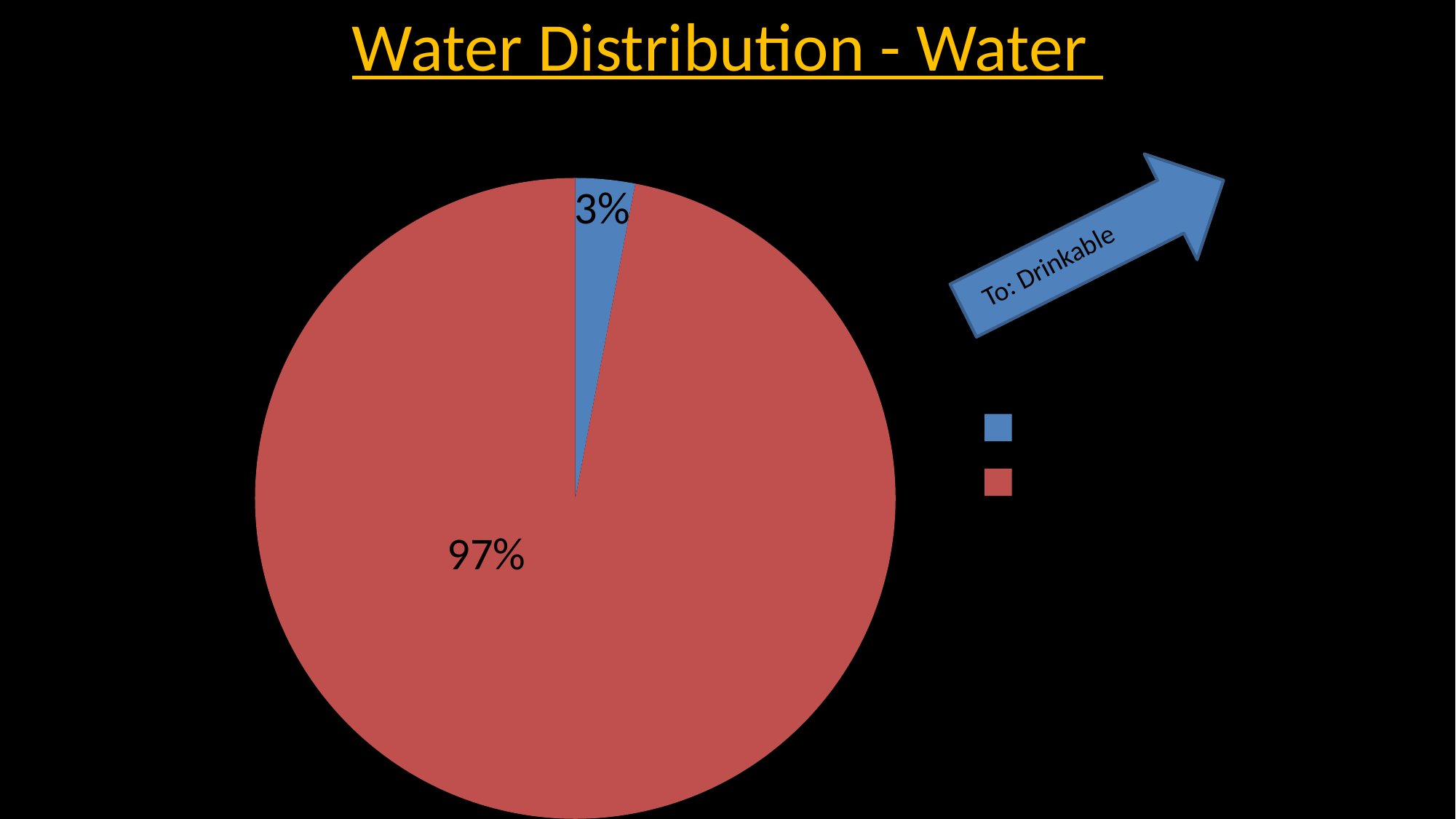
How many slices does the pie chart have? 2 What do the two slice percentages add up to? 100% What is the title of the slide? Water Distribution - Water Which is larger, the blue slice or the red slice? the red slice What kind of chart is shown on the slide? pie chart Which slice of the pie is the largest? the red slice (97%) Which slice of the pie is the smallest? the blue slice (3%) How many entries does the legend show? 2 What is the difference in percentage points between the red slice and the blue slice? 94 What share of the pie does the blue slice represent? 3% What share of the pie does the red slice represent? 97% What text is written on the arrow pointing away from the blue slice? To: Drinkable